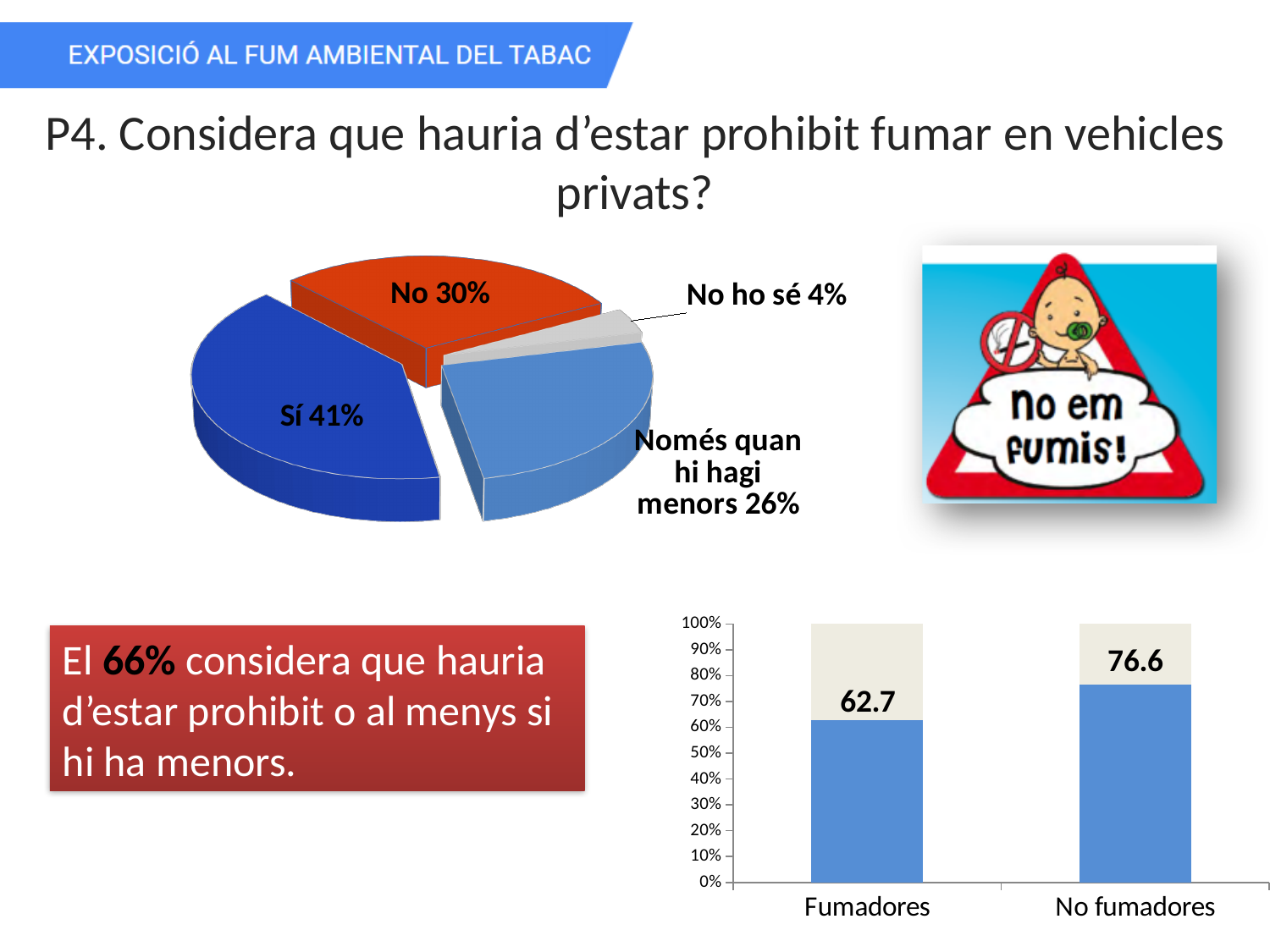
In the bar chart at the bottom right, which category has the higher labelled value, Fumadores or No fumadores? No fumadores In the pie chart, what percentage answered "No ho sé"? 4% In the pie chart, what percentage answered "Només quan hi hagi menors"? 26% What kind of chart is shown at the top left of the slide? Pie chart In the pie chart, how many slices are there? 4 In the bar chart at the bottom right, what is the labelled value for "Fumadores"? 62.7 In the bar chart at the bottom right, what is the difference between the labelled values for No fumadores and Fumadores? 13.9 In the pie chart, how many percentage points larger is "Sí" than "No"? 11 In the pie chart, what percentage of respondents answered "Sí"? 41% In the pie chart, which response has the smallest share? No ho sé In the bar chart at the bottom right, what is the labelled value for "No fumadores"? 76.6 In the pie chart, which response has the largest share? Sí